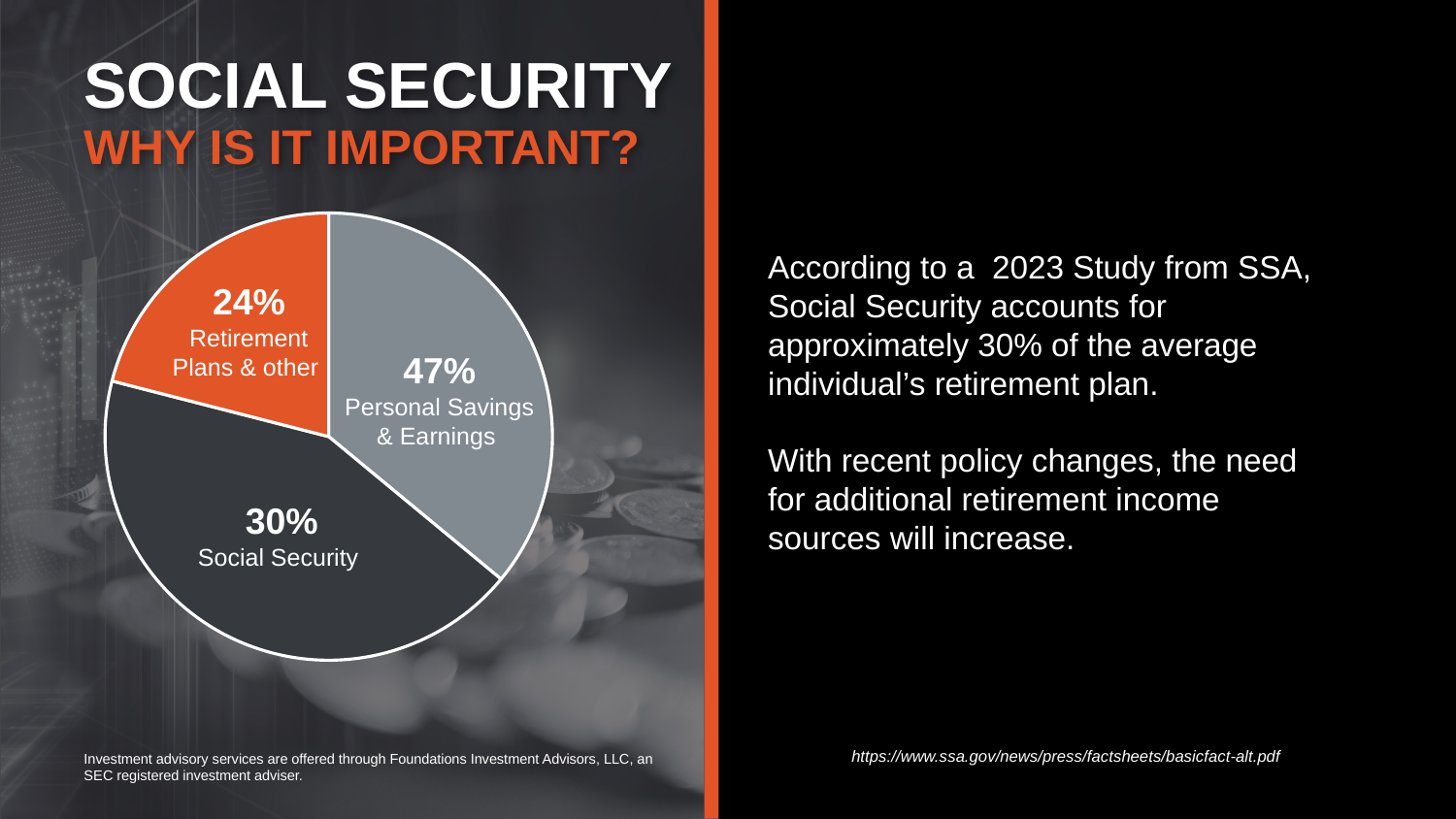
What is the combined share of Social Security and Retirement Plans & other? 54% What is the difference in percentage points between Personal Savings & Earnings and Social Security? 17 What percentage is shown for Retirement Plans & other? 24% Which slice of the pie is the smallest? Retirement Plans & other What kind of chart is shown on the slide? Pie chart What is the difference in percentage points between Social Security and Retirement Plans & other? 6 What colour is the Retirement Plans & other slice? Orange Which slice of the pie is the largest? Personal Savings & Earnings What percentage is shown for Personal Savings & Earnings? 47% How many slices does the pie chart have? 3 Which is larger, the Social Security slice or the Retirement Plans & other slice? Social Security What share of the pie does Social Security account for? 30%